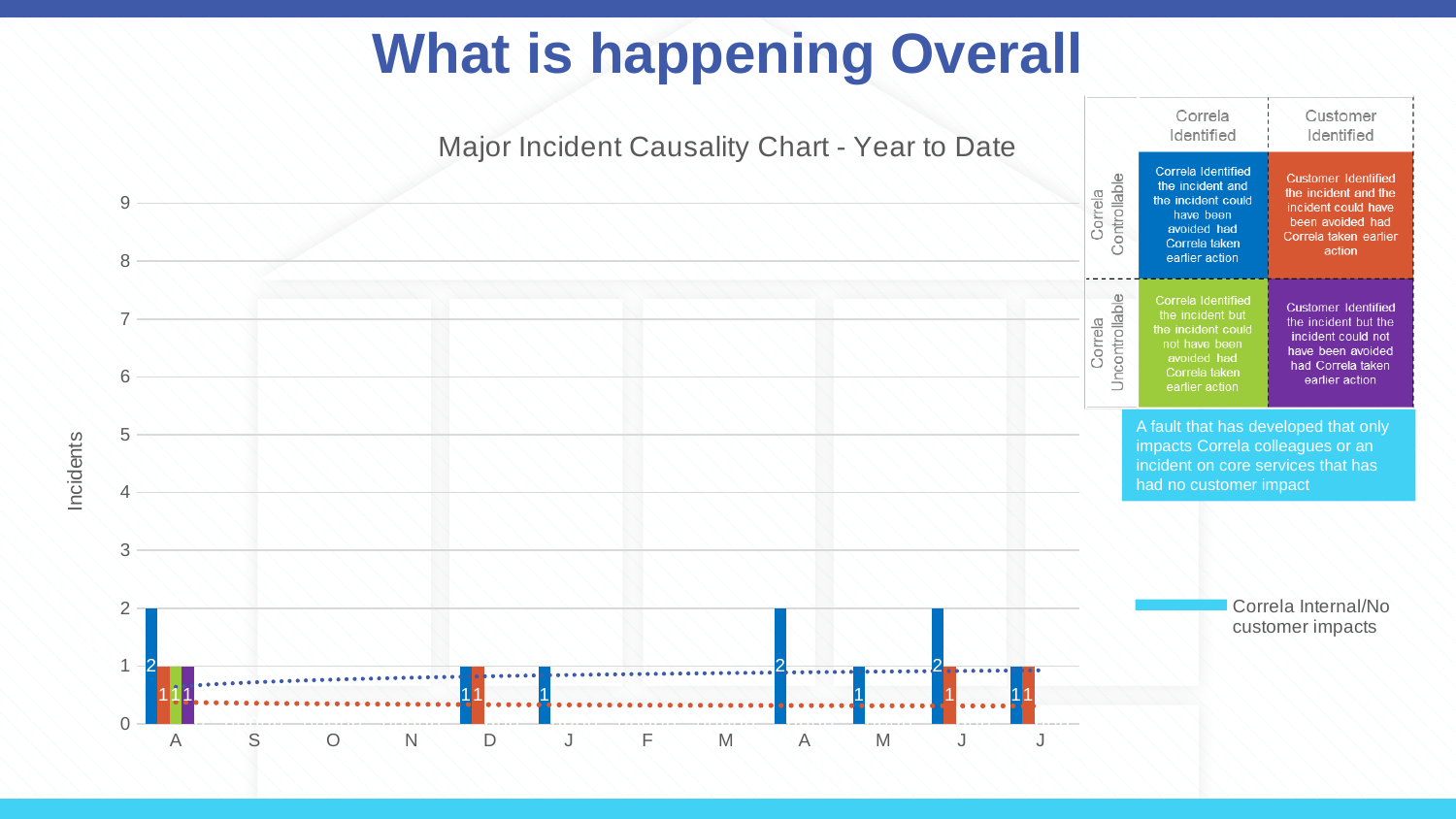
What is the value of the blue bar in the second month labelled A (ninth month) on the chart? 2 What is the label on the vertical axis of the chart? Incidents How many months on the chart have no bars plotted at all? 5 What type of chart is the Major Incident Causality Chart? bar chart Is the tallest bar on the chart greater or less than 5? less What is the value of the blue bar in the first month (leftmost A) on the chart? 2 What is the highest value shown on the y axis of the chart? 9 Which is larger on the chart: the blue bar in the first month (leftmost A) or the blue bar in the month labelled D? the blue bar in the first month (A) How many bars are plotted in the first month (leftmost A) on the chart? 4 How many month labels are shown along the x axis of the chart? 12 What is the value of the blue bar in the month labelled D on the chart? 1 What is the title of the chart on the slide? Major Incident Causality Chart - Year to Date